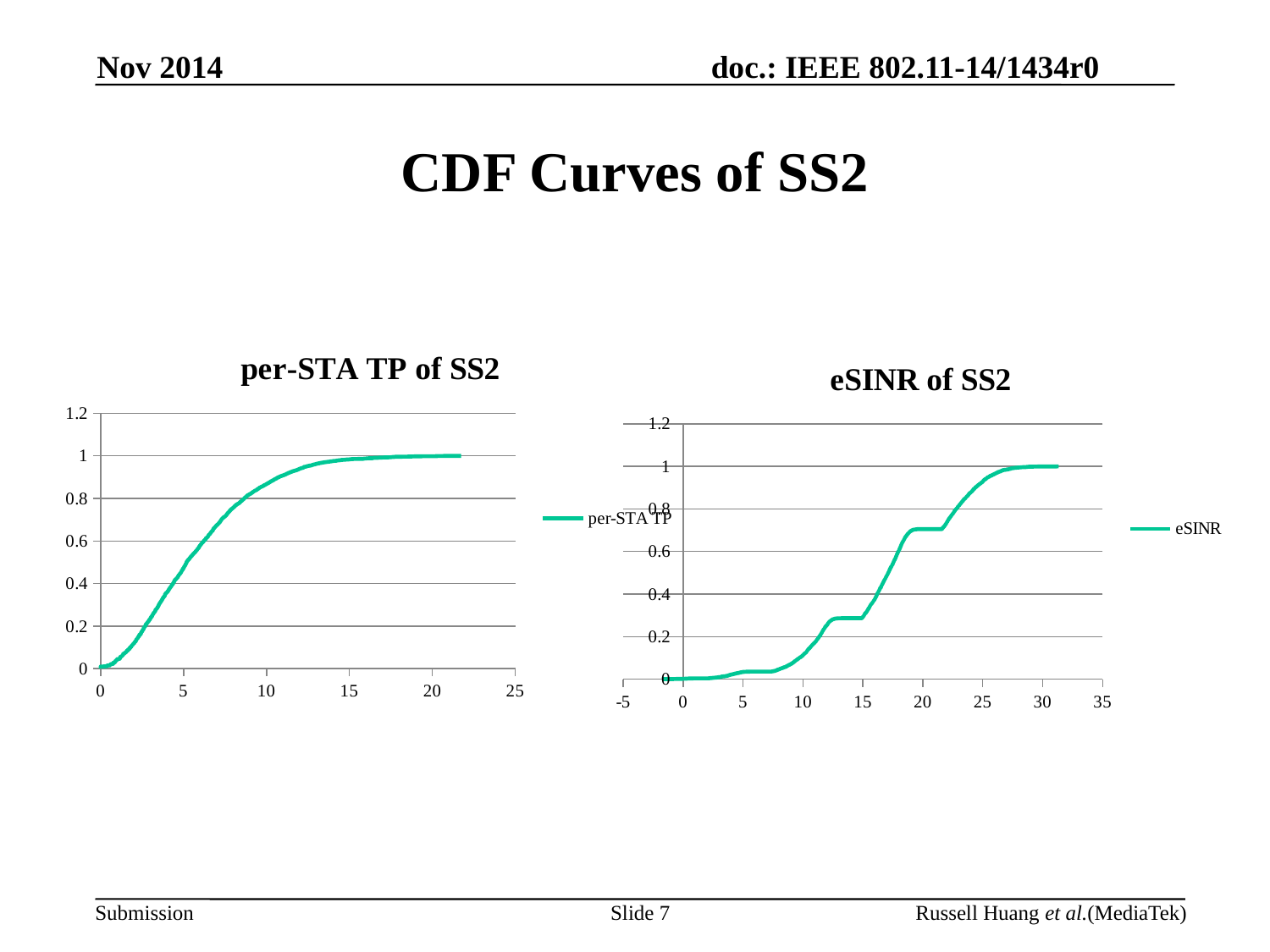
In the "per-STA TP of SS2" chart, do the values rise or fall as x increases? rise In the "per-STA TP of SS2" chart, is the value at x = 5 greater or less than 0.6? less What is the title of the chart on the left of the slide? per-STA TP of SS2 What kind of chart is the "eSINR of SS2" chart? line chart In the "eSINR of SS2" chart, is the value at x = 20 greater or less than 0.6? greater What is the legend entry of the "eSINR of SS2" chart? eSINR In the "per-STA TP of SS2" chart, is the value at x = 10 greater or less than 0.8? greater In the "eSINR of SS2" chart, do the values rise or fall as x increases? rise What kind of chart is the "per-STA TP of SS2" chart? line chart How many series does the legend of the "eSINR of SS2" chart list? 1 How many series does the legend of the "per-STA TP of SS2" chart list? 1